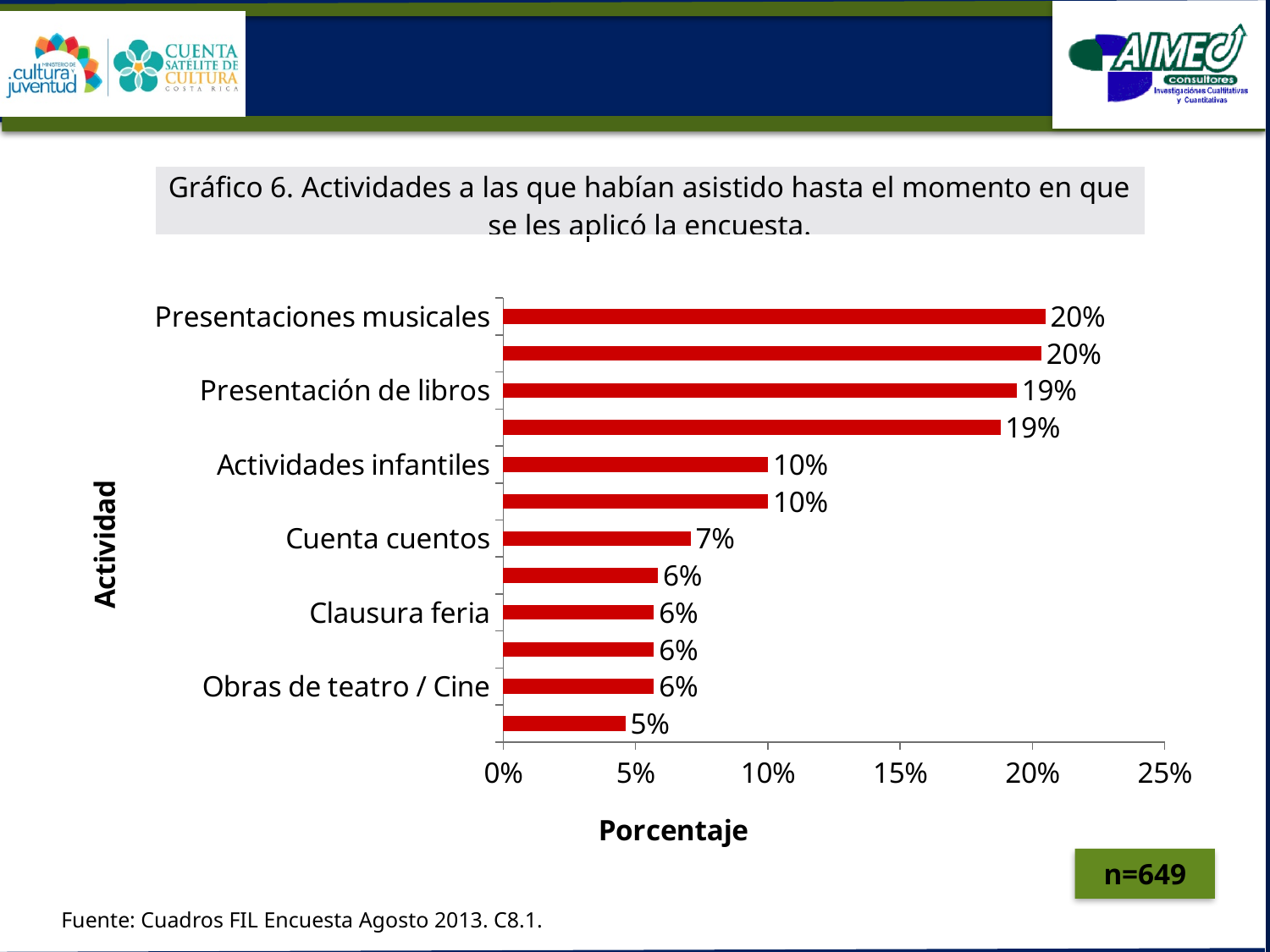
What is the value for Clausura feria? 6% What is the difference between the values for Presentaciones musicales and Cuenta cuentos? 13 percentage points What is the title of the horizontal axis of the chart? Porcentaje What is the value for Cuenta cuentos? 7% What is the value for Obras de teatro / Cine? 6% How many bars are plotted in the chart? 12 Which is larger, the value for Presentación de libros or the value for Actividades infantiles? Presentación de libros What kind of chart is shown on the slide? bar chart What is the value for Presentaciones musicales? 20% Is the value for Cuenta cuentos greater or less than 10%? less What is the value for Presentación de libros? 19% What is the value for Actividades infantiles? 10%